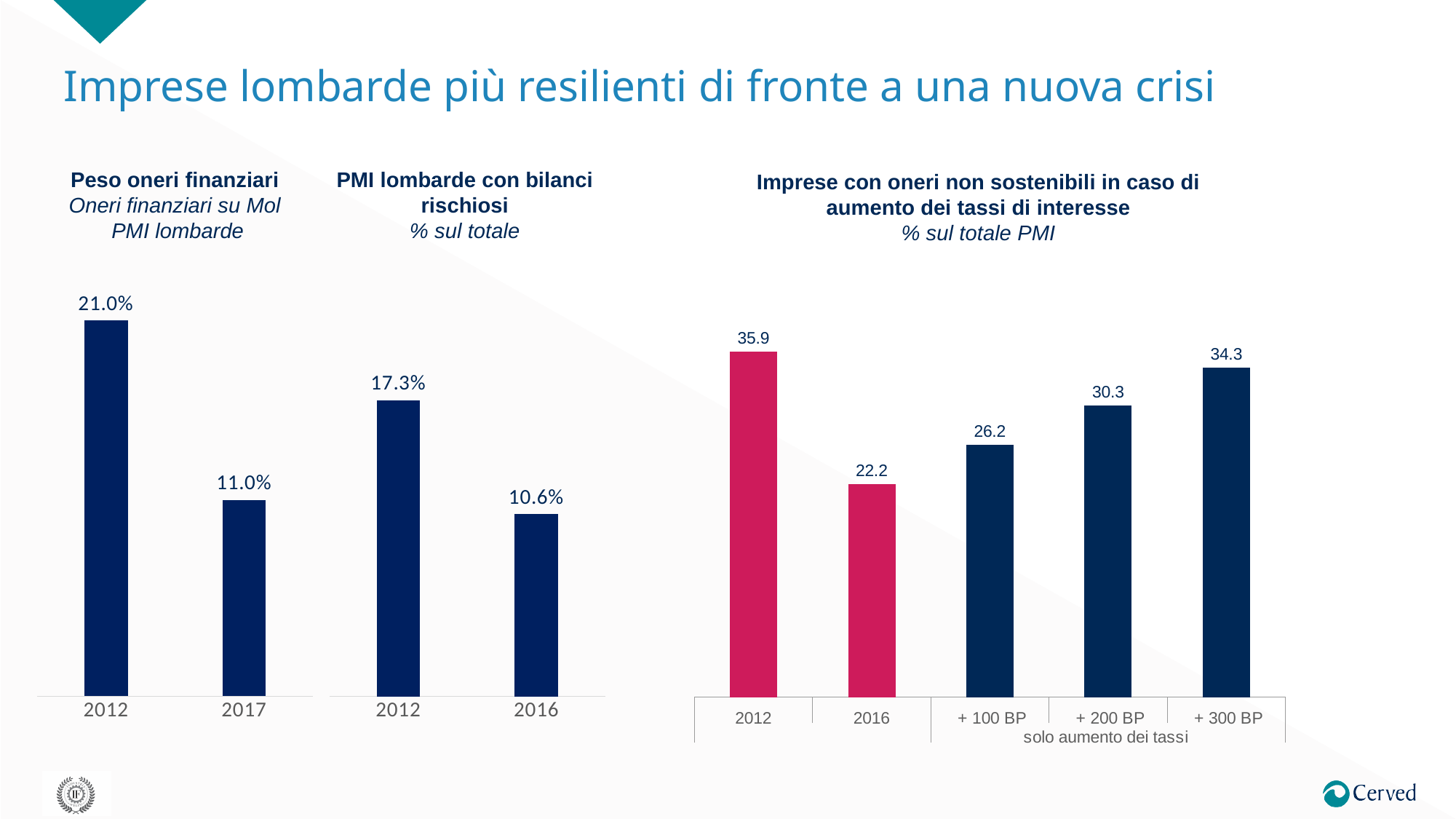
In the 'Imprese con oneri non sostenibili' chart, what is the difference between the + 300 BP and + 100 BP values? 8.1 In the 'Imprese con oneri non sostenibili' chart, which category has the highest value? 2012 In the 'Peso oneri finanziari' chart, what is the difference between the 2012 and 2017 values? 10.0% In the 'Imprese con oneri non sostenibili' chart, which category has the lowest value? 2016 In the 'PMI lombarde con bilanci rischiosi' chart, what is the value for 2016? 10.6% In the 'PMI lombarde con bilanci rischiosi' chart, which year has the higher value, 2012 or 2016? 2012 In the 'PMI lombarde con bilanci rischiosi' chart, what is the difference between the 2012 and 2016 values? 6.7% In the 'Peso oneri finanziari' chart, what is the value for 2012? 21.0% In the 'Imprese con oneri non sostenibili' chart, what is the value for + 200 BP? 30.3 In the 'Peso oneri finanziari' chart, what is the value for 2017? 11.0% What type of chart is the 'Peso oneri finanziari' chart? Bar chart In the 'Imprese con oneri non sostenibili' chart, how many bars are plotted? 5